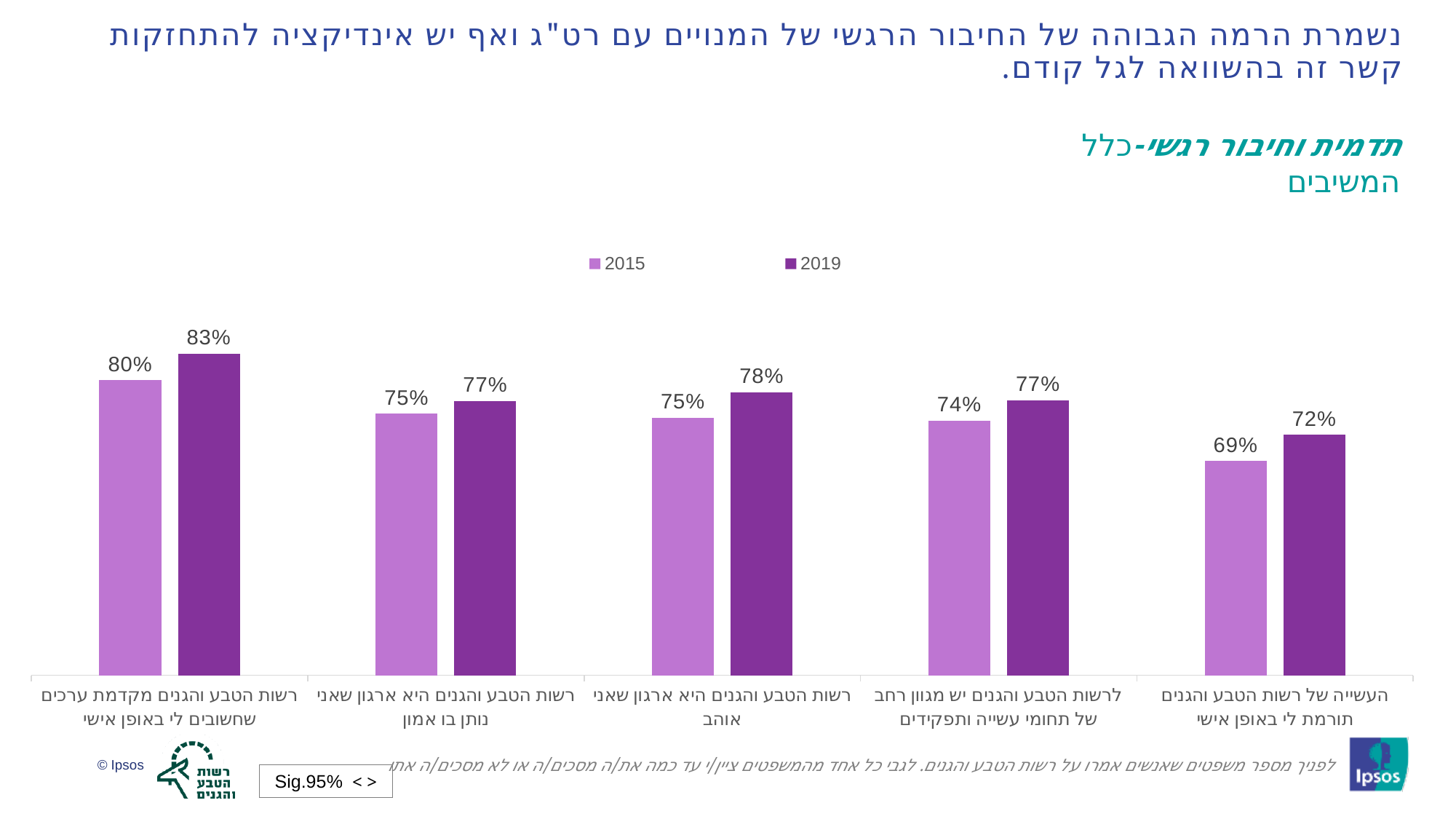
What is the difference between the 2019 and 2015 values for "לרשות הטבע והגנים יש מגוון רחב של תחומי עשייה ותפקידים"? 3% What kind of chart is shown on the slide? Bar chart What is the 2019 value for "רשות הטבע והגנים היא ארגון שאני אוהב"? 78% What is the difference between the 2019 and 2015 values for "רשות הטבע והגנים מקדמת ערכים שחשובים לי באופן אישי"? 3% What is the 2019 value for "רשות הטבע והגנים מקדמת ערכים שחשובים לי באופן אישי"? 83% How many categories are shown on the x axis? 5 Which category has the lowest 2015 value? העשייה של רשות הטבע והגנים תורמת לי באופן אישי How many series does the legend list? 2 What is the 2015 value for "לרשות הטבע והגנים יש מגוון רחב של תחומי עשייה ותפקידים"? 74% What is the 2015 value for "העשייה של רשות הטבע והגנים תורמת לי באופן אישי"? 69% Which category has the highest 2019 value? רשות הטבע והגנים מקדמת ערכים שחשובים לי באופן אישי Which is larger: the 2019 value for "רשות הטבע והגנים היא ארגון שאני אוהב" or the 2019 value for "העשייה של רשות הטבע והגנים תורמת לי באופן אישי"? רשות הטבע והגנים היא ארגון שאני אוהב